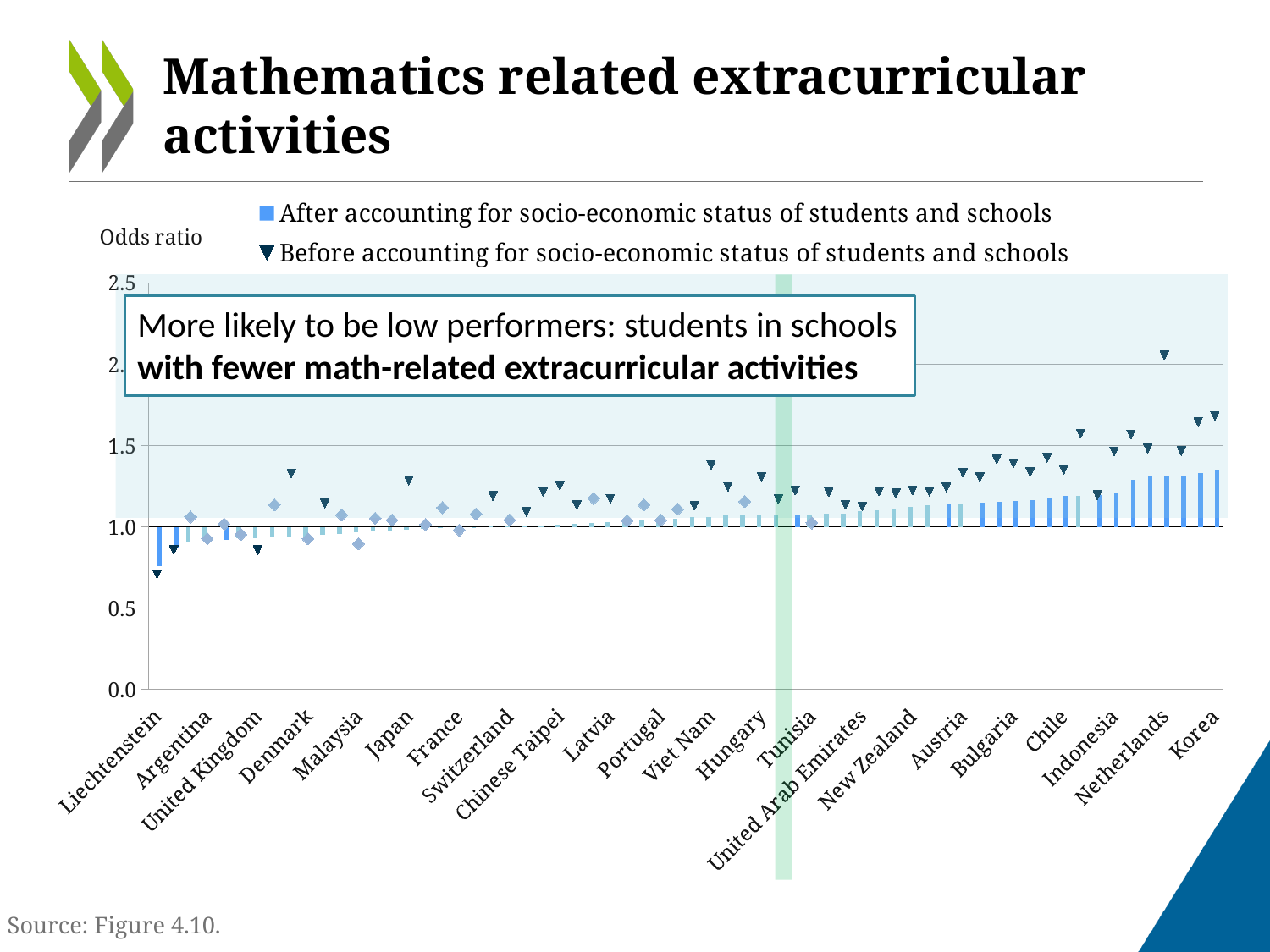
Is the 'After accounting for socio-economic status' value for Korea greater or less than 1.0? greater Is the 'Before accounting for socio-economic status' value for Liechtenstein greater or less than 1.0? less How many series does the legend list? 2 Is the 'Before accounting for socio-economic status' value for Korea greater or less than 1.5? greater Which country is highlighted with a green vertical band on the chart? Tunisia Which has the larger 'After accounting for socio-economic status' value, Liechtenstein or Korea? Korea What is the label on the vertical axis of the chart? Odds ratio Do the odds ratios generally rise or fall moving from left to right along the x axis? Rise Which country appears first (leftmost) on the x axis? Liechtenstein Which has the larger 'Before accounting for socio-economic status' value, Liechtenstein or Korea? Korea What kind of chart is shown on the slide? Bar chart